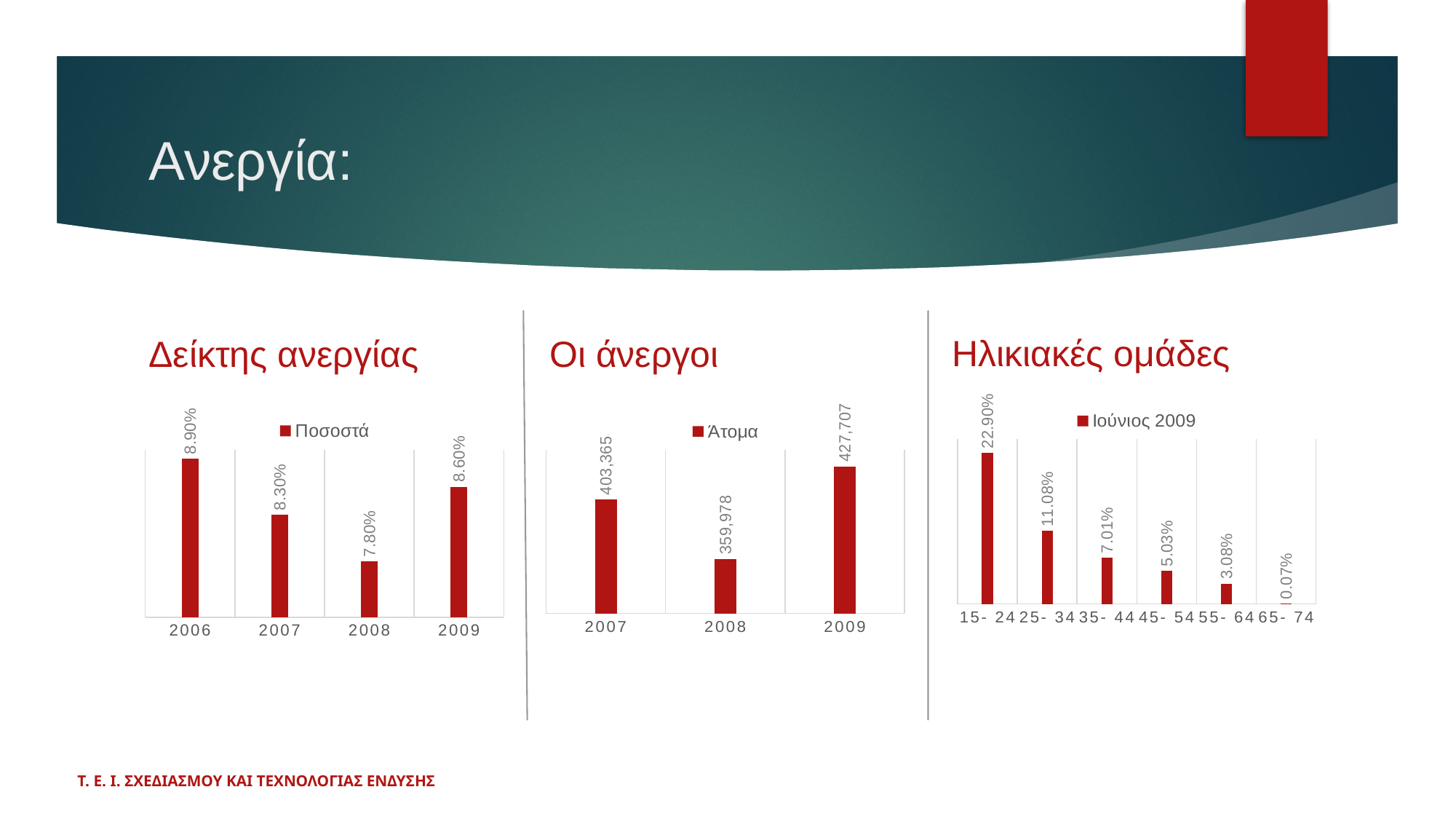
In the middle chart (Οι άνεργοι), what is the value for 2008? 359,978 In the left chart (Δείκτης ανεργίας), how many years are shown on the x axis? 4 In the left chart (Δείκτης ανεργίας), which year has the lowest value? 2008 In the middle chart (Οι άνεργοι), which year has the highest value? 2009 In the left chart (Δείκτης ανεργίας), what is the value for 2006? 8.90% In the right chart (Ηλικιακές ομάδες), do the values rise or fall from left to right along the x axis? fall In the middle chart (Οι άνεργοι), what is the legend entry? Άτομα In the right chart (Ηλικιακές ομάδες), what is the value for the 25-34 age group? 11.08% In the right chart (Ηλικιακές ομάδες), which age group has the lowest value? 65-74 In the middle chart (Οι άνεργοι), what is the difference between the 2009 and 2008 values? 67,729 In the left chart (Δείκτης ανεργίας), what is the difference between the 2006 and 2008 values? 1.10% What kind of chart is the right chart (Ηλικιακές ομάδες)? bar chart